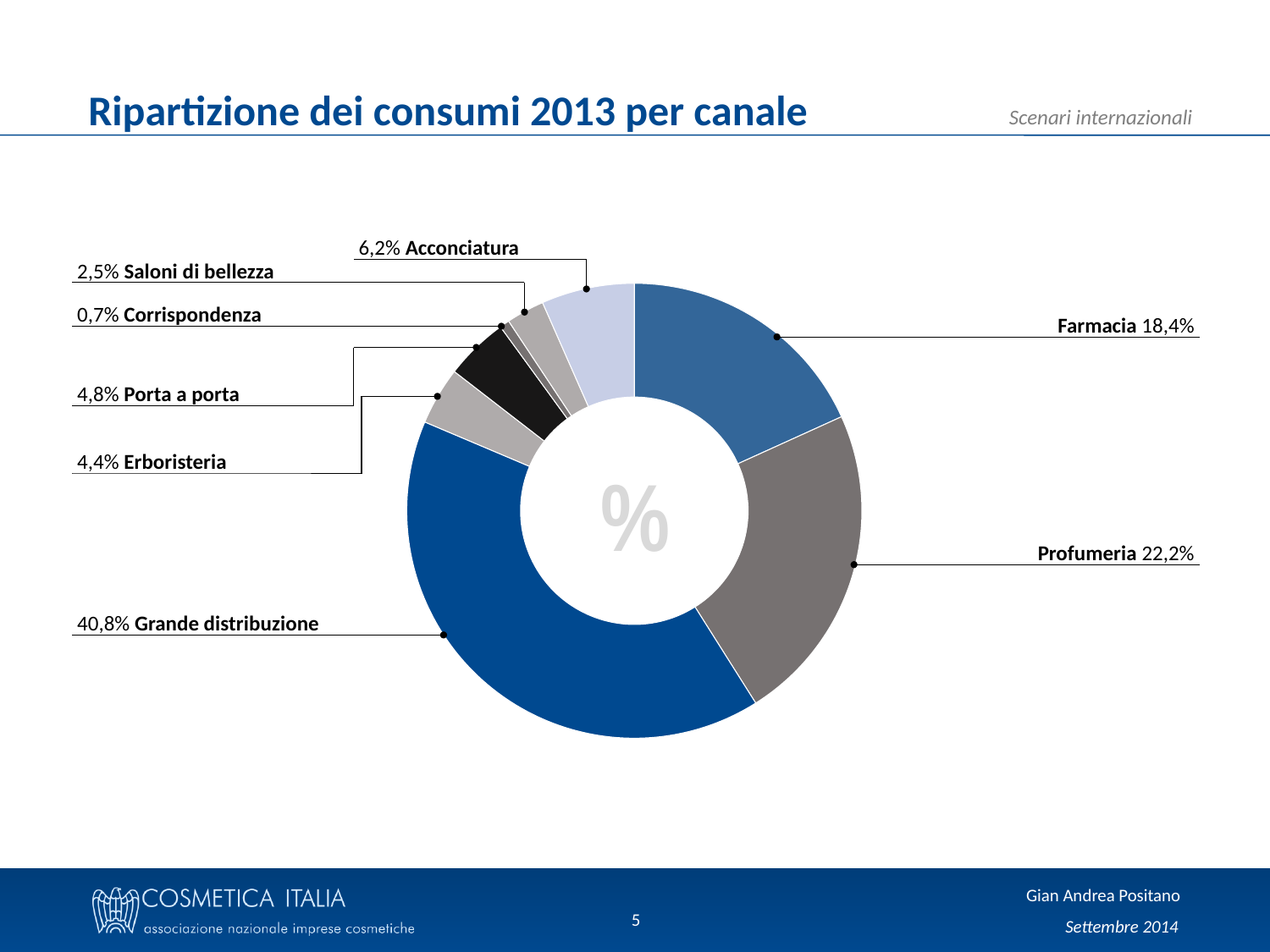
What share of 2013 consumption does Grande distribuzione account for? 40,8% What is the value shown for Farmacia? 18,4% Which channel has the largest share of consumption? Grande distribuzione What is the combined share of Saloni di bellezza and Acconciatura? 8,7% How many channels are shown in the chart? 8 What is the value for Corrispondenza? 0,7% Which has a larger share, Porta a porta or Erboristeria? Porta a porta What is the difference in percentage points between Profumeria and Farmacia? 3,8 Which channel has the smallest share of consumption? Corrispondenza What percentage is shown for Profumeria? 22,2% What is the title of the chart on the slide? Ripartizione dei consumi 2013 per canale What kind of chart is shown on the slide? Pie chart (donut)